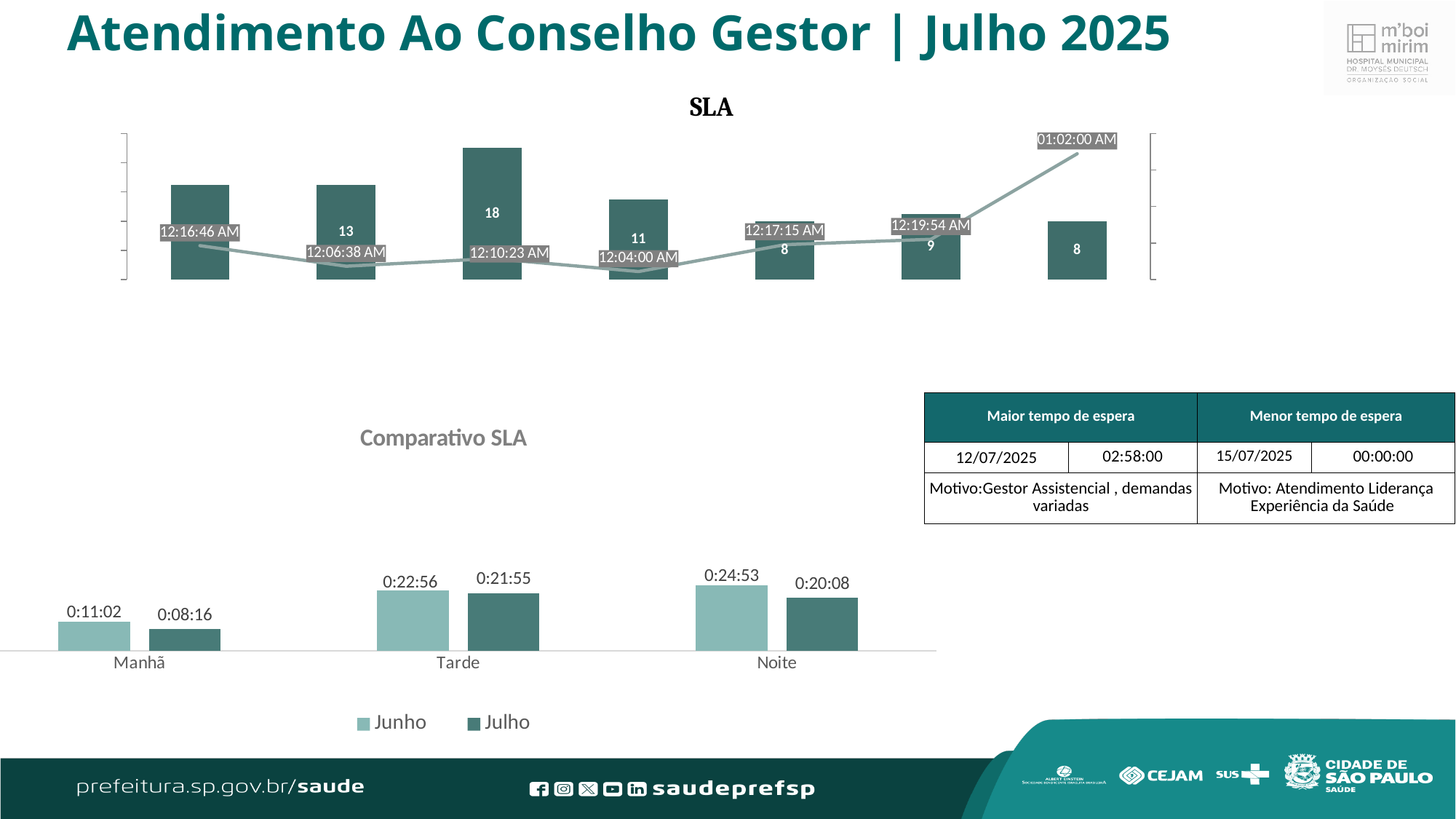
In the SLA chart at the top, what is the highest bar value shown? 18 In the Comparativo SLA chart, what is the Julho value for Tarde? 0:21:55 In the Comparativo SLA chart, which category has the highest Junho value? Noite In the Comparativo SLA chart, how many series does the legend list? 2 In the SLA chart at the top, what is the highest value labelled on the line? 01:02:00 AM In the Comparativo SLA chart, for Noite, which is larger: Junho or Julho? Junho In the Comparativo SLA chart, what is the Junho value for Manhã? 0:11:02 In the Comparativo SLA chart, how many categories are shown on the x axis? 3 What kind of chart is the Comparativo SLA chart? Bar chart In the Comparativo SLA chart, which category has the lowest Julho value? Manhã In the Comparativo SLA chart, what is the Julho value for Noite? 0:20:08 In the SLA chart at the top, how many bars are plotted? 7